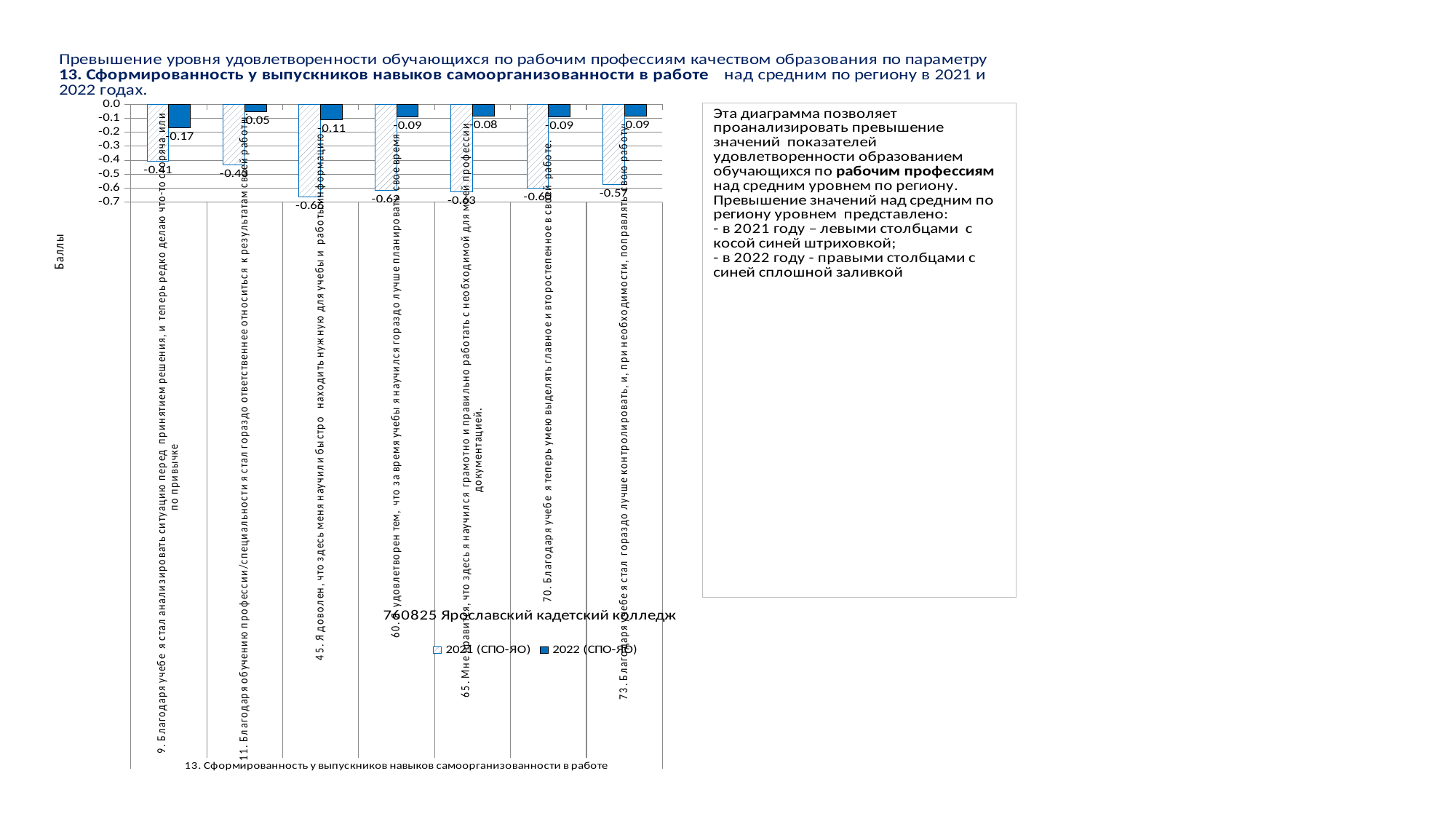
How many series does the chart legend list? 2 Is the 2021 (СПО-ЯО) value for category 45 (Я доволен, что здесь меня научили быстро находить нужную для учебы и работы информацию) greater or less than -0.6? less Which category has the lowest 2022 (СПО-ЯО) value? 9. Благодаря учебе я стал анализировать ситуацию перед принятием решения, и теперь редко делаю что-то сгоряча или по привычке What is the 2022 (СПО-ЯО) value for category 9 (Благодаря учебе я стал анализировать ситуацию перед принятием решения...)? -0.17 What is the 2021 (СПО-ЯО) value for category 60 (Я удовлетворен тем, что за время учебы я научился гораздо лучше планировать свое время)? -0.62 What is the 2022 (СПО-ЯО) value for category 65 (Мне нравится, что здесь я научился грамотно и правильно работать с необходимой для моей профессии документацией)? -0.08 Which is larger, the 2022 (СПО-ЯО) value for category 9 or for category 11? Category 11 (-0.05) What is the difference between the 2021 (СПО-ЯО) and 2022 (СПО-ЯО) values for category 9? 0.24 How many categories are shown on the x axis of the chart? 7 Which category has the highest 2022 (СПО-ЯО) value? 11. Благодаря обучению профессии/специальности я стал гораздо ответственнее относиться к результатам своей работы What is the 2021 (СПО-ЯО) value for category 73 (Благодаря учебе я стал гораздо лучше контролировать... свою работу)? -0.57 What is the 2022 (СПО-ЯО) value for category 11 (Благодаря обучению профессии/специальности я стал гораздо ответственнее...)? -0.05